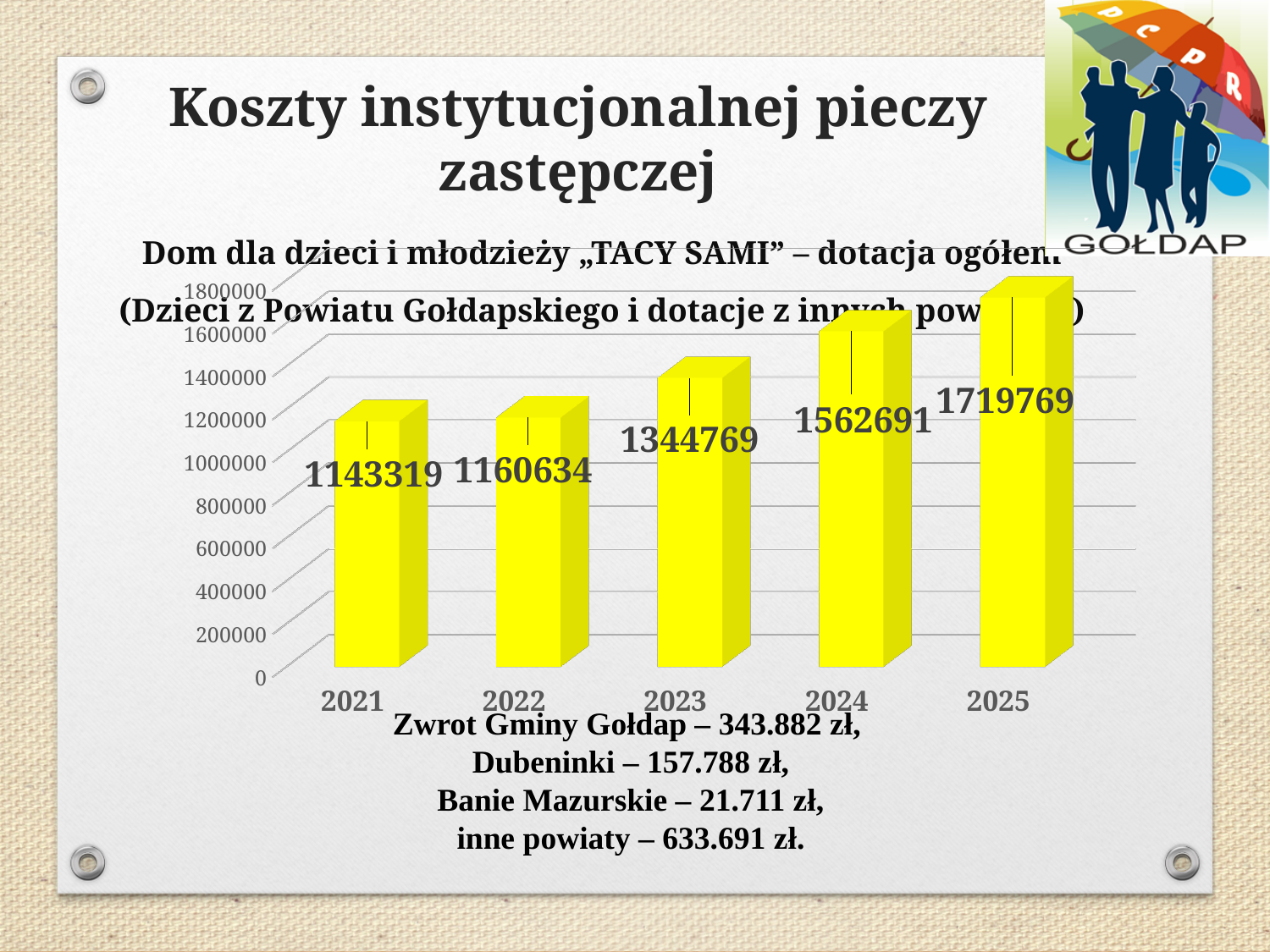
Do the values rise or fall from 2021 to 2025? rise What is the value for 2025? 1719769 How many years are shown on the x axis? 5 What is the value for 2024? 1562691 What is the value for 2023? 1344769 Is the value for 2024 greater or less than 1400000? greater Which year has the lowest value? 2021 What is the difference between the values for 2025 and 2021? 576450 Which is larger, the value for 2022 or the value for 2023? 2023 What is the value for 2021? 1143319 Which year has the highest value? 2025 What is the difference between the values for 2024 and 2023? 217922